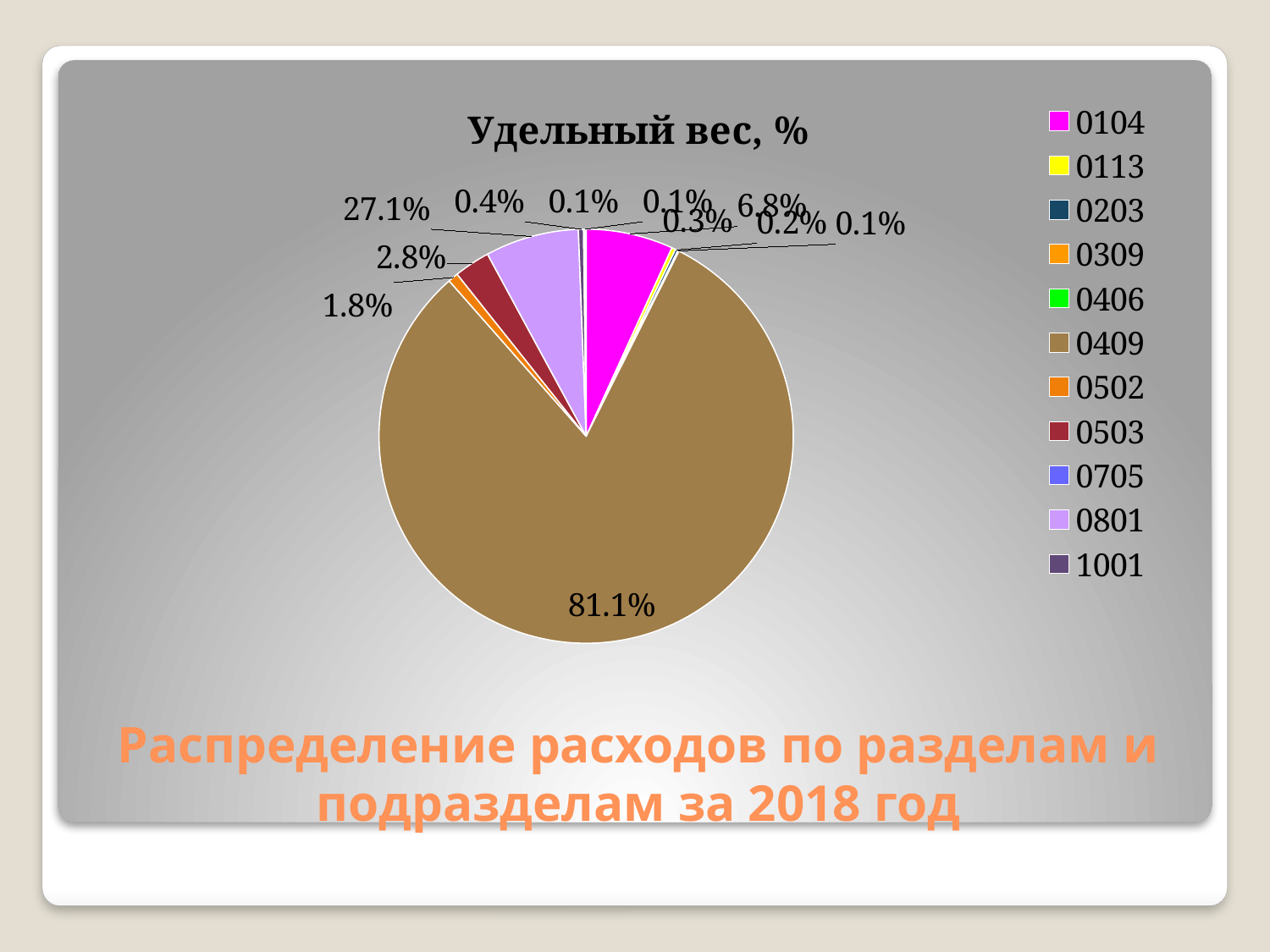
What share of the pie does category 0409 have? 81.1% How many categories does the chart legend list? 11 Which is larger, the slice for 0409 or the slice for 0104? 0409 What is the value shown for category 0104? 6.8% What kind of chart is shown on the slide? pie chart What is the title of the chart? Удельный вес, % What colour is the slice for category 0409? brown Which category has the largest slice of the pie? 0409 What is the difference between the values for 0409 and 0104? 74.3%